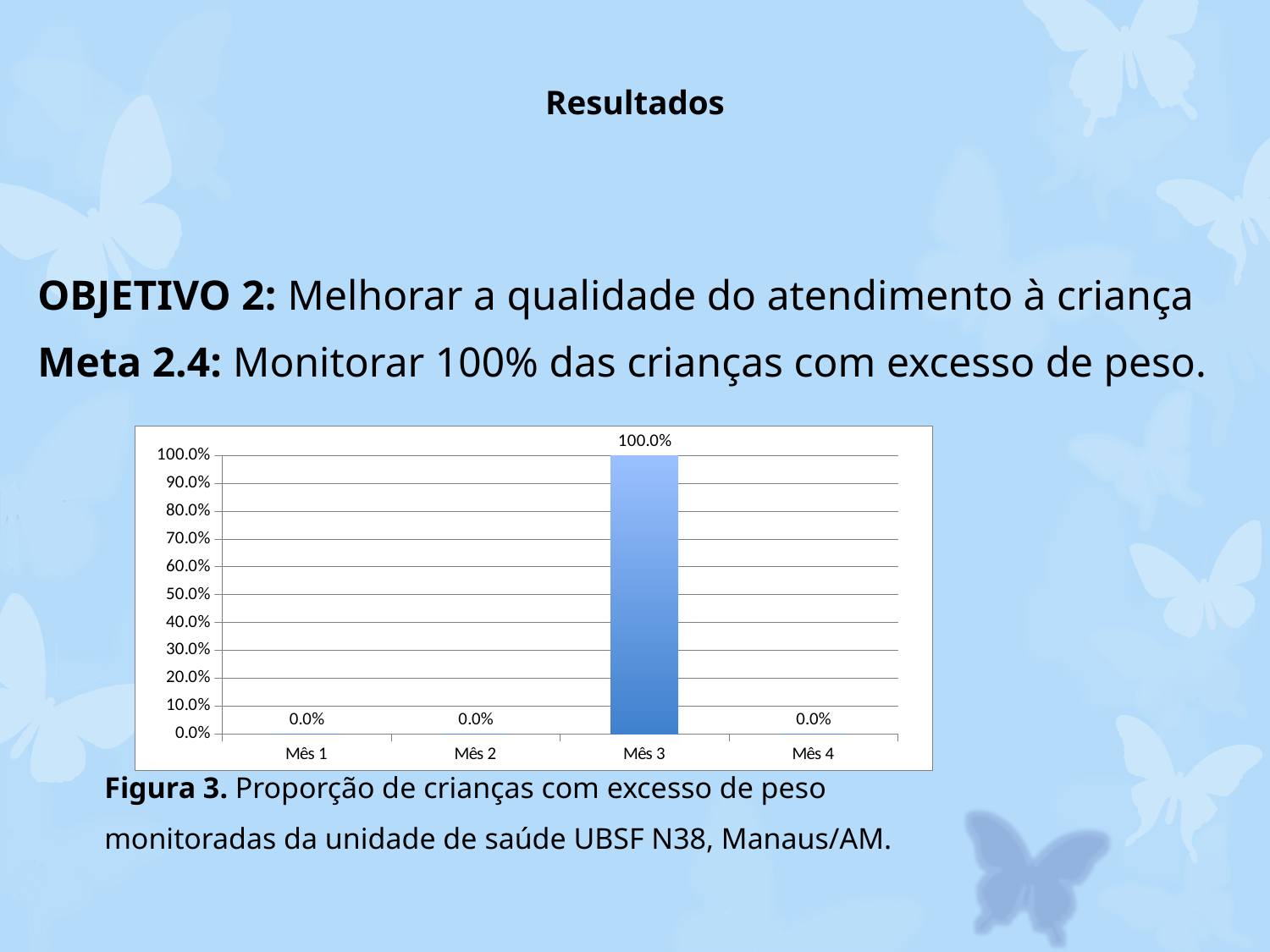
Which is larger, the value for Mês 3 or the value for Mês 4? Mês 3 What is the figure number given in the caption below the chart? Figura 3 Which month has the highest value? Mês 3 What is the difference between the values for Mês 3 and Mês 2? 100.0% What is the value for Mês 3? 100.0% What is the value for Mês 4? 0.0% How many months are shown on the x axis? 4 Is the value for Mês 3 greater or less than 50.0%? greater What is the highest value shown on the y axis? 100.0% How many months have a value of 0.0%? 3 What is the value for Mês 1? 0.0% What kind of chart is shown on the slide? bar chart